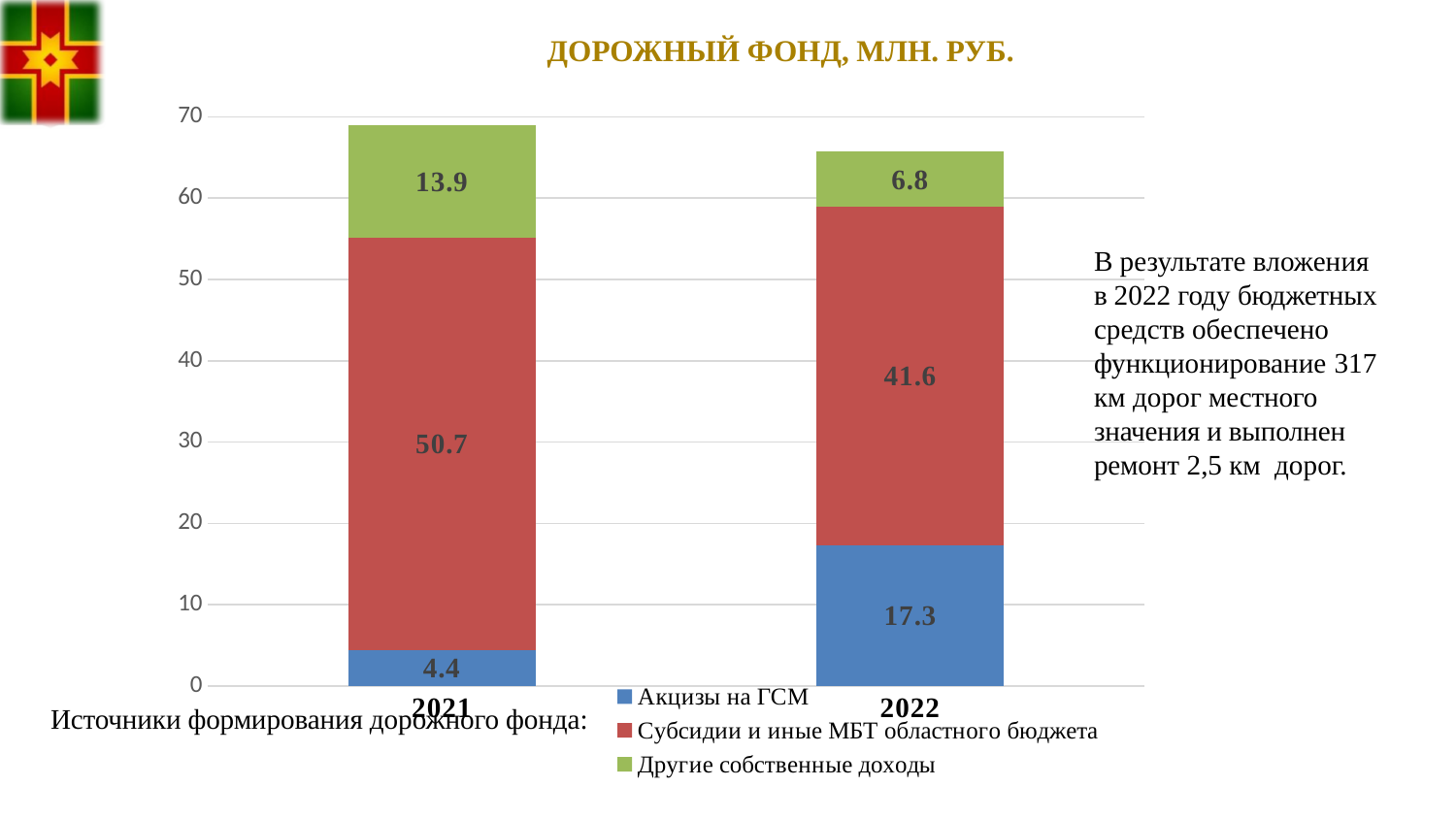
What is the value for Акцизы на ГСМ in 2021? 4.4 What is the value for Другие собственные доходы in 2021? 13.9 What is the title of the chart? ДОРОЖНЫЙ ФОНД, МЛН. РУБ. What is the value for Акцизы на ГСМ in 2022? 17.3 How many series does the legend list? 3 Which series has the highest value in 2022? Субсидии и иные МБТ областного бюджета What is the value for Субсидии и иные МБТ областного бюджета in 2022? 41.6 What is the difference between the Субсидии и иные МБТ областного бюджета values for 2021 and 2022? 9.1 What kind of chart is shown on the slide? Stacked bar chart What is the total of the stacked bar for 2022? 65.7 Which year has the larger value for Акцизы на ГСМ, 2021 or 2022? 2022 What is the total of the stacked bar for 2021? 69.0